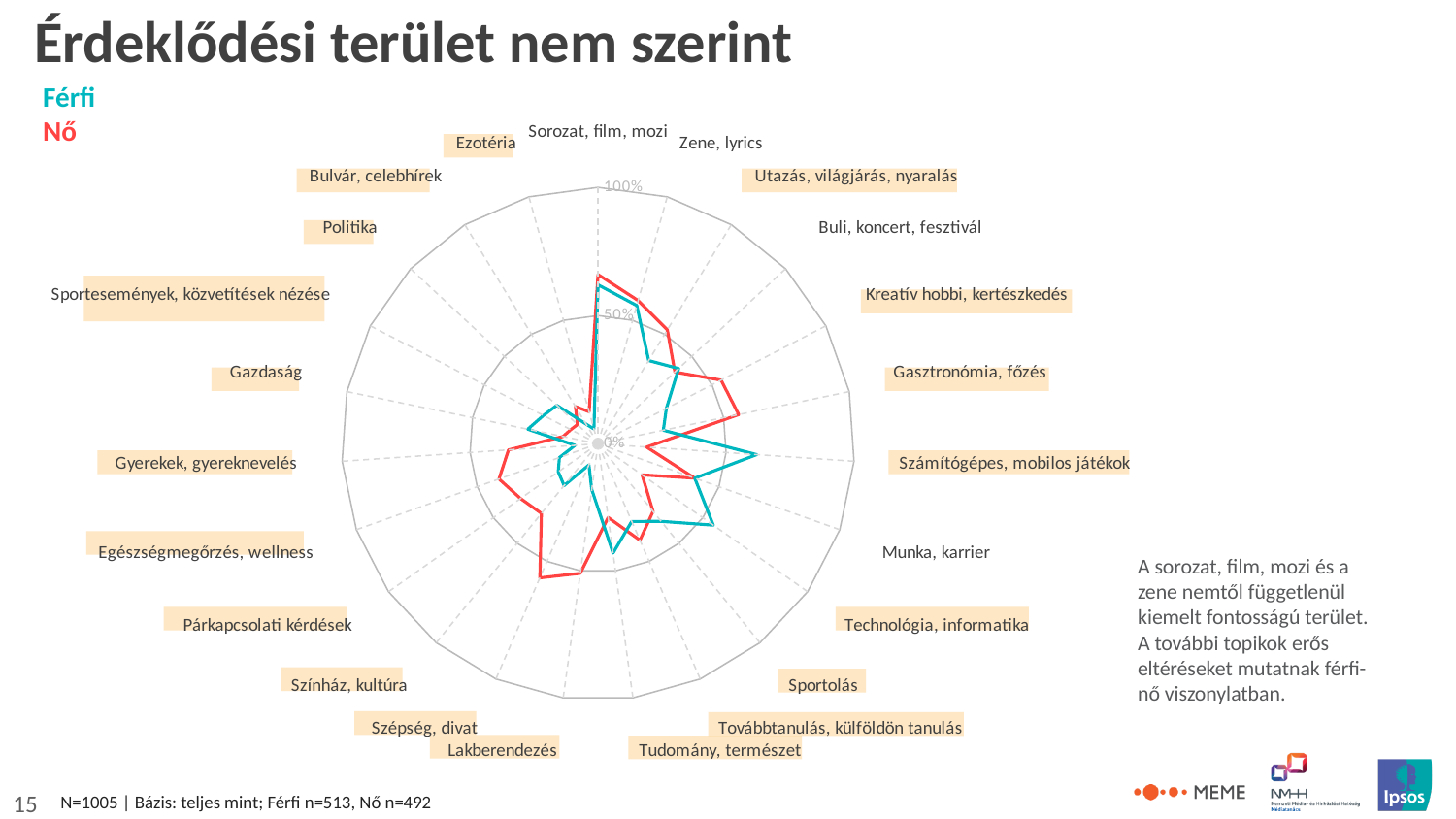
Which series has the larger value for Gasztronómia, főzés, Férfi or Nő? Nő Is the Férfi value for Számítógépes, mobilos játékok greater or less than 50%? greater Which series has the larger value for Szépség, divat, Férfi or Nő? Nő Is the Férfi value for Politika greater or less than 50%? less Which series has the larger value for Sportesemények, közvetítések nézése, Férfi or Nő? Férfi How many series does the chart's legend list? 2 How many categories (interest areas) are plotted on the radar chart? 23 Is the Nő value for Számítógépes, mobilos játékok greater or less than 50%? less What is the title of the slide's chart? Érdeklődési terület nem szerint What colour is the line for the Nő series? Red What kind of chart is shown on the slide? Radar chart